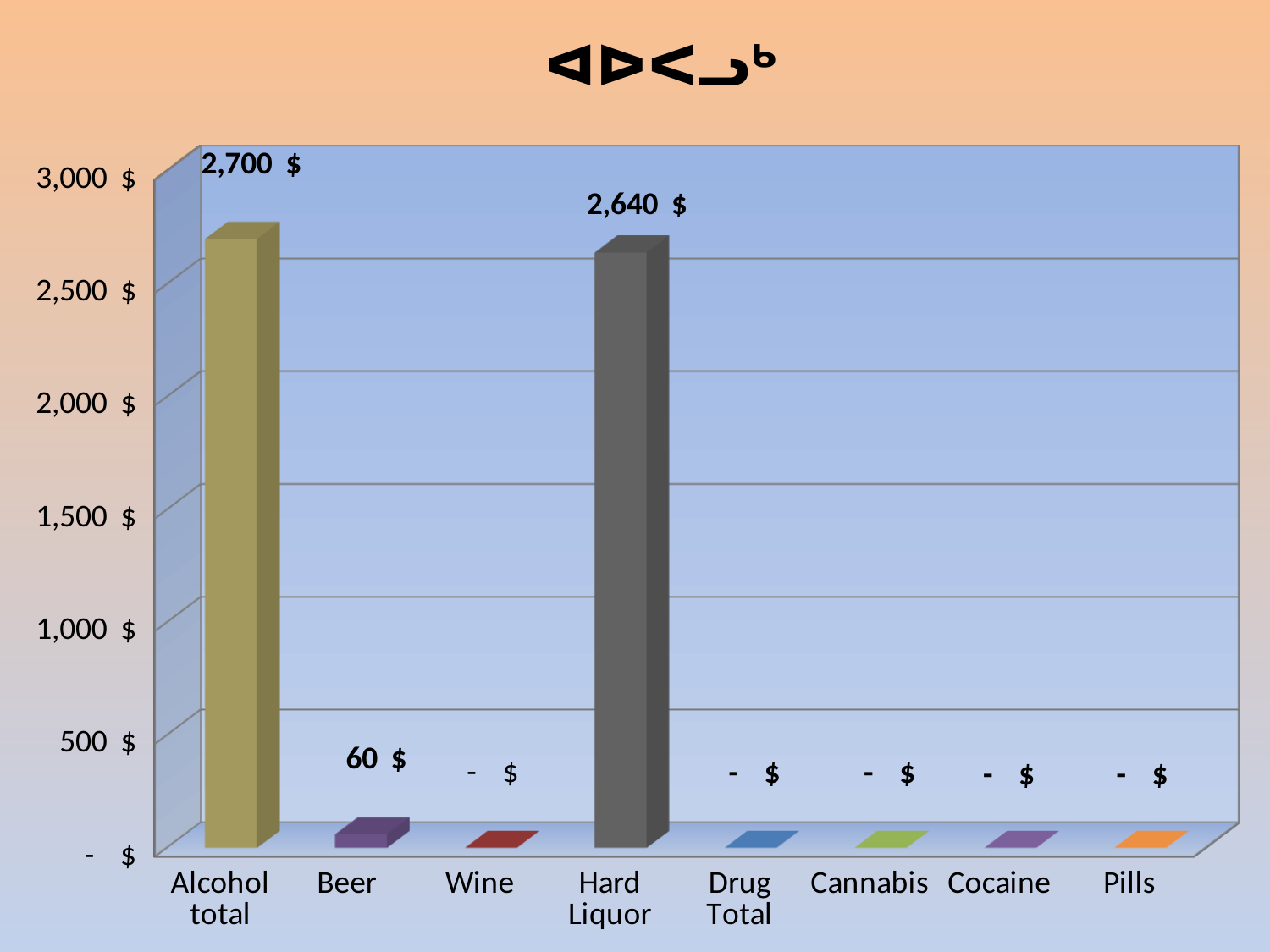
What is the value for Alcohol total? 2,700 $ How many categories have a data label of "- $"? 5 How many categories are shown on the x axis? 8 Is the value for Hard Liquor greater or less than 2,500? greater Is the value for Beer greater or less than 500? less What is the value for Beer? 60 $ Which is larger, the value for Beer or the value for Hard Liquor? Hard Liquor What kind of chart is shown on the slide? bar chart What is the difference between the values for Alcohol total and Hard Liquor? 60 $ What is the difference between the values for Hard Liquor and Beer? 2,580 $ Which category has the highest value? Alcohol total What is the value for Hard Liquor? 2,640 $